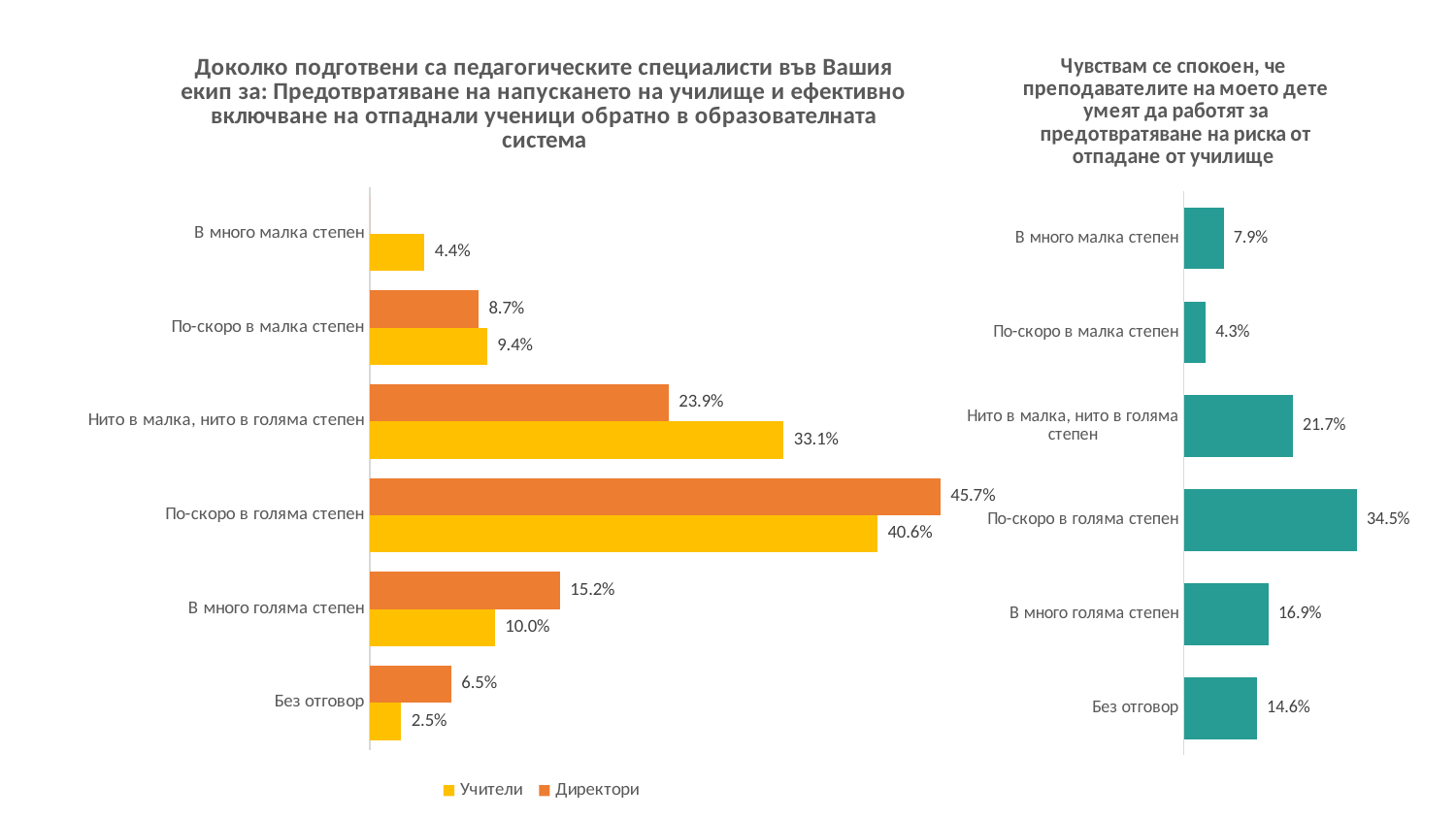
In the left chart, what is the value for Учители for 'По-скоро в голяма степен'? 40.6% In the left chart, what is the difference between Директори and Учители for 'В много голяма степен'? 5.2% What type of chart is the right chart? Bar chart In the left chart, what is the value for Директори for 'Нито в малка, нито в голяма степен'? 23.9% In the left chart, for 'Нито в малка, нито в голяма степен', which series has the larger value, Учители or Директори? Учители How many categories are shown in the right chart? 6 How many series does the legend of the left chart list? 2 In the right chart, which category has the lowest value? По-скоро в малка степен In the left chart, which category has the lowest value for Учители? Без отговор In the right chart, what is the value for 'По-скоро в голяма степен'? 34.5% In the right chart, what is the difference between 'Нито в малка, нито в голяма степен' and 'В много голяма степен'? 4.8% In the left chart, which category has the highest value for Директори? По-скоро в голяма степен